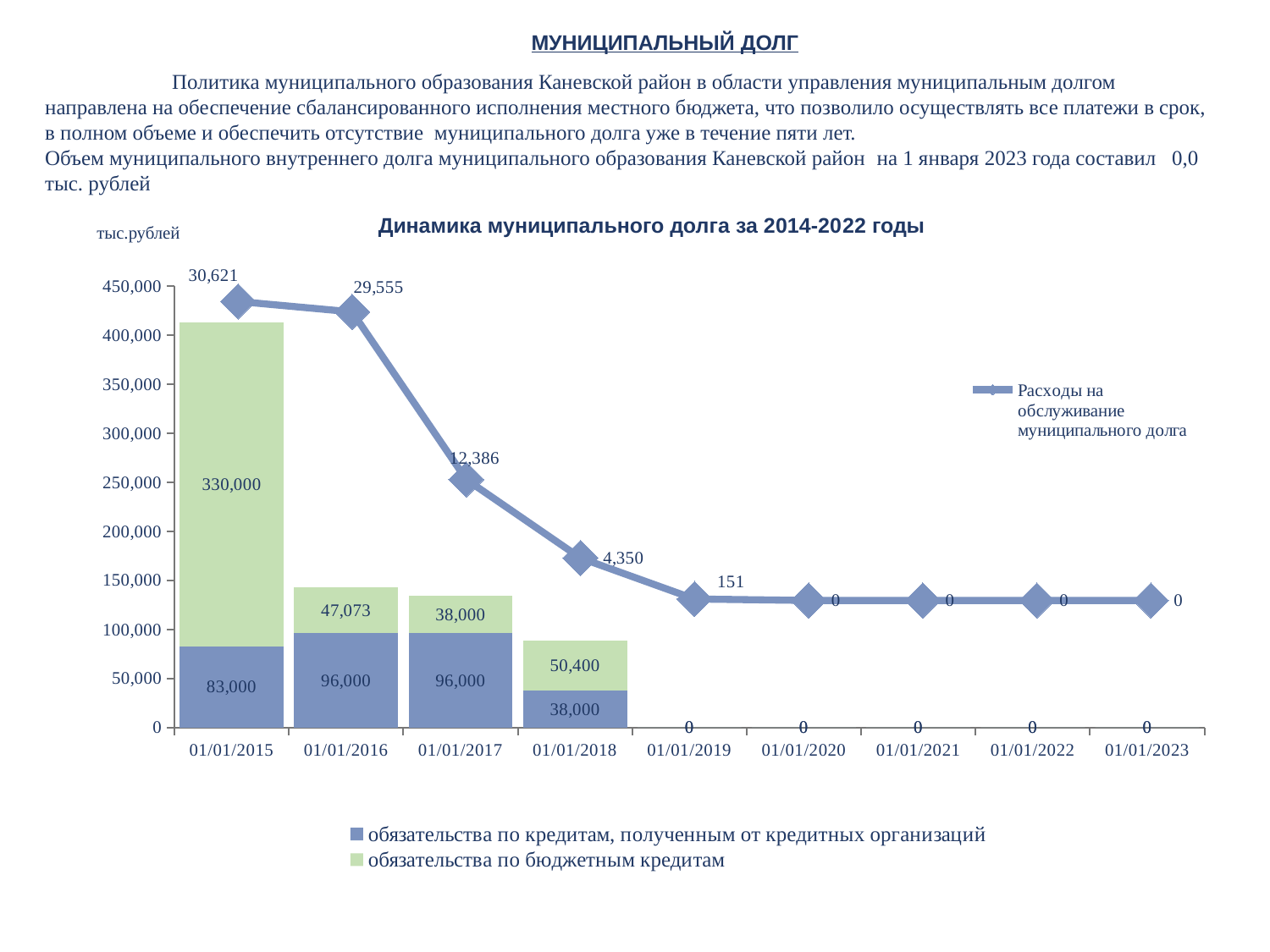
Which is larger on 01/01/2017: 'обязательства по кредитам, полученным от кредитных организаций' or 'обязательства по бюджетным кредитам'? обязательства по кредитам, полученным от кредитных организаций Does 'Расходы на обслуживание муниципального долга' rise or fall from 01/01/2015 to 01/01/2019? fall What is the total of the stacked bar for 01/01/2016? 143,073 What is the value of 'Расходы на обслуживание муниципального долга' on 01/01/2017? 12,386 What is the title of the chart? Динамика муниципального долга за 2014-2022 годы How many dates are shown on the x axis? 9 What is the difference between 'Расходы на обслуживание муниципального долга' on 01/01/2015 and on 01/01/2016? 1,066 What is the value of 'обязательства по кредитам, полученным от кредитных организаций' on 01/01/2018? 38,000 What is the value of 'Расходы на обслуживание муниципального долга' on 01/01/2019? 151 On which date is 'Расходы на обслуживание муниципального долга' highest? 01/01/2015 What is the total of the stacked bar for 01/01/2018? 88,400 What is the value of 'обязательства по бюджетным кредитам' on 01/01/2015? 330,000